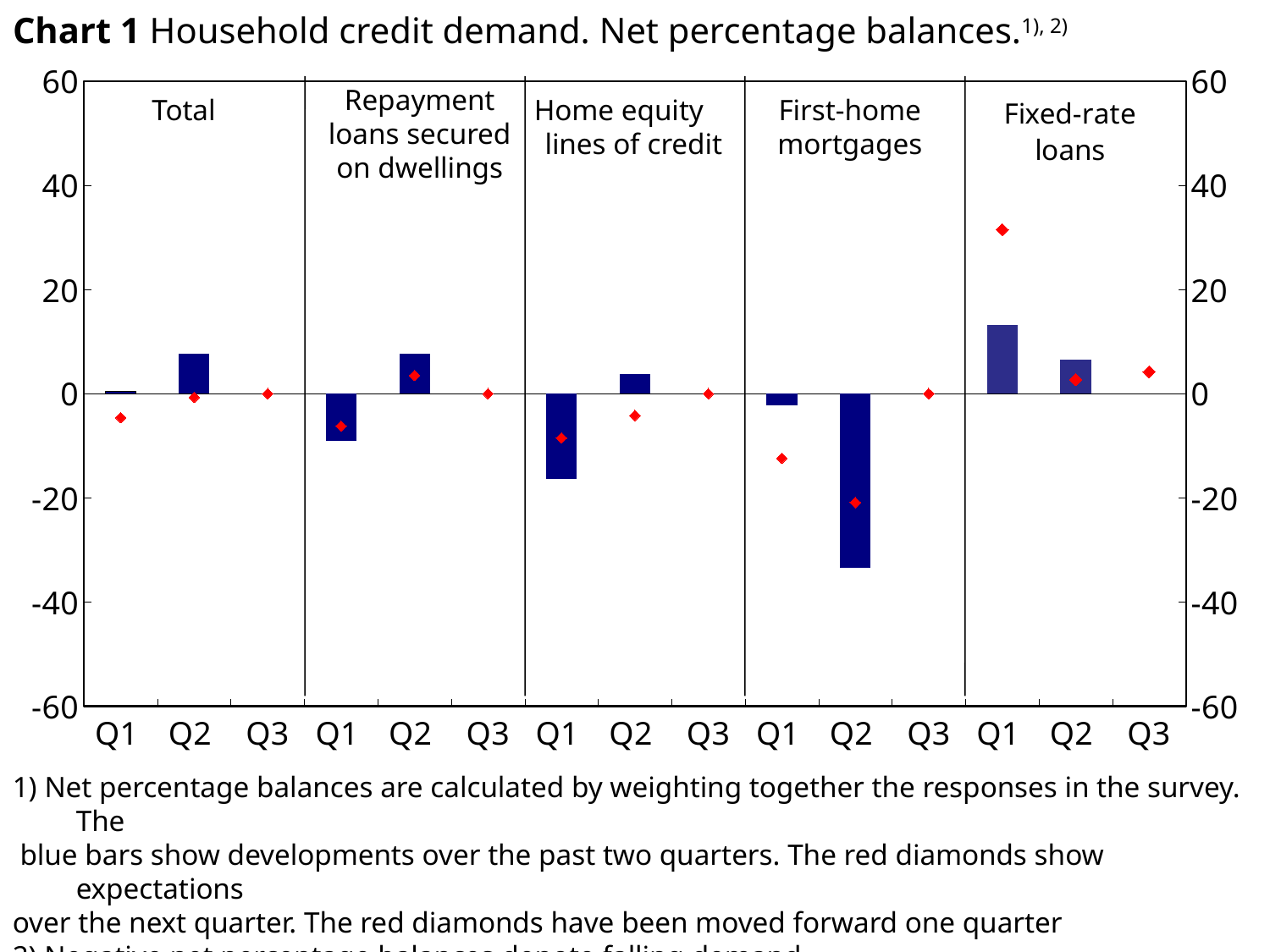
Is the Q1 bar for Fixed-rate loans greater or less than 10? greater According to the footnote, what do the red diamonds show? Expectations over the next quarter Which panel contains the lowest (most negative) blue bar in Chart 1? First-home mortgages Which panel contains the highest blue bar in Chart 1? Fixed-rate loans How many credit categories (panels) are shown in Chart 1? 5 How many quarters are shown on the x axis within each panel of Chart 1? 3 Which Q1 bar is lower: Repayment loans secured on dwellings or Home equity lines of credit? Home equity lines of credit Do the blue bars for Fixed-rate loans rise or fall from Q1 to Q2? fall Is the Q2 bar for First-home mortgages greater or less than -20? less What kind of chart is Chart 1? bar chart Is the Q1 bar for Home equity lines of credit greater or less than -10? less